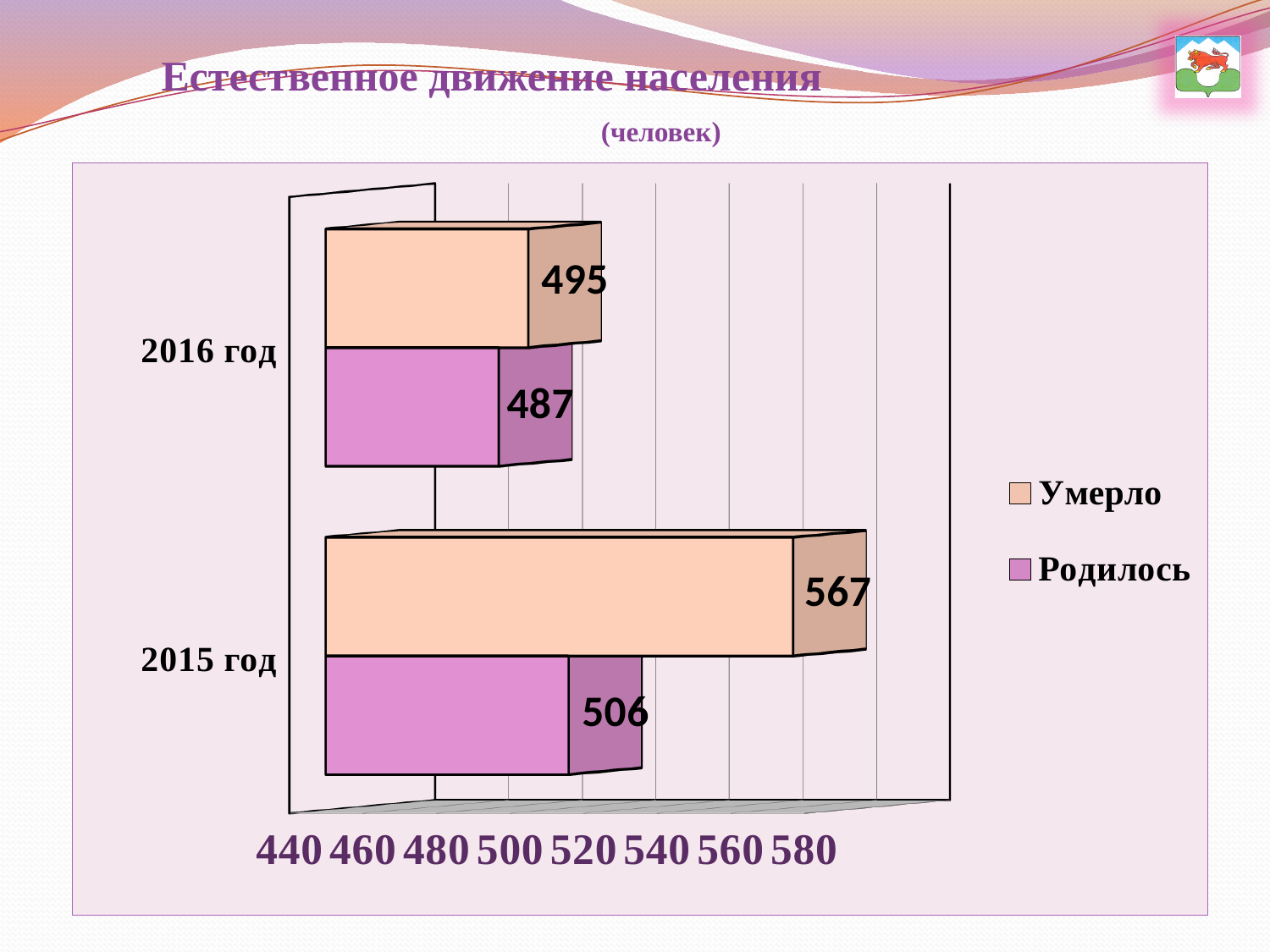
What was the value for Родилось in 2016 год? 487 What is the difference between Умерло in 2015 год and Умерло in 2016 год? 72 What was the value for Родилось in 2015 год? 506 How many series does the legend list? 2 Which is larger in 2016 год: Умерло or Родилось? Умерло What is the difference between Умерло and Родилось in 2015 год? 61 Which year had the highest value for Умерло? 2015 год Which year had the lowest value for Родилось? 2016 год What was the value for Умерло in 2016 год? 495 What unit is given in the chart subtitle? человек What kind of chart is shown on the slide? Bar chart What was the value for Умерло in 2015 год? 567